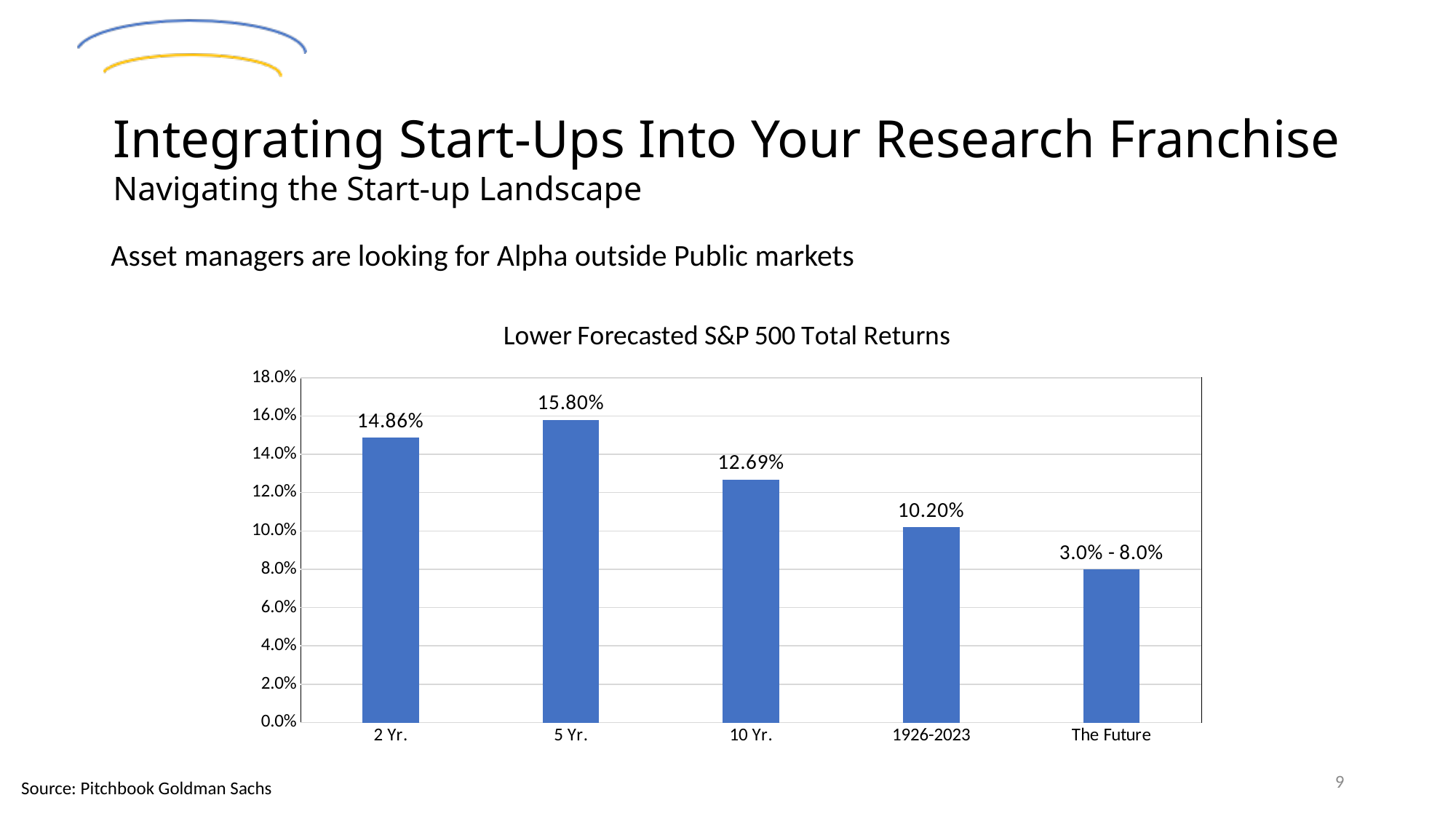
Which category has the highest value? 5 Yr. Which is larger, the value for 10 Yr. or the value for 1926-2023? 10 Yr. Which category has the lowest bar? The Future What is the title of the chart? Lower Forecasted S&P 500 Total Returns What is the value for 10 Yr.? 12.69% Is the value for The Future greater or less than 10.0%? less What is the value for 5 Yr.? 15.80% What is the value for 2 Yr.? 14.86% What is the difference between the 5 Yr. and 2 Yr. values? 0.94% What label is shown on the bar for The Future? 3.0% - 8.0% How many categories are shown on the x axis? 5 What is the value for 1926-2023? 10.20%